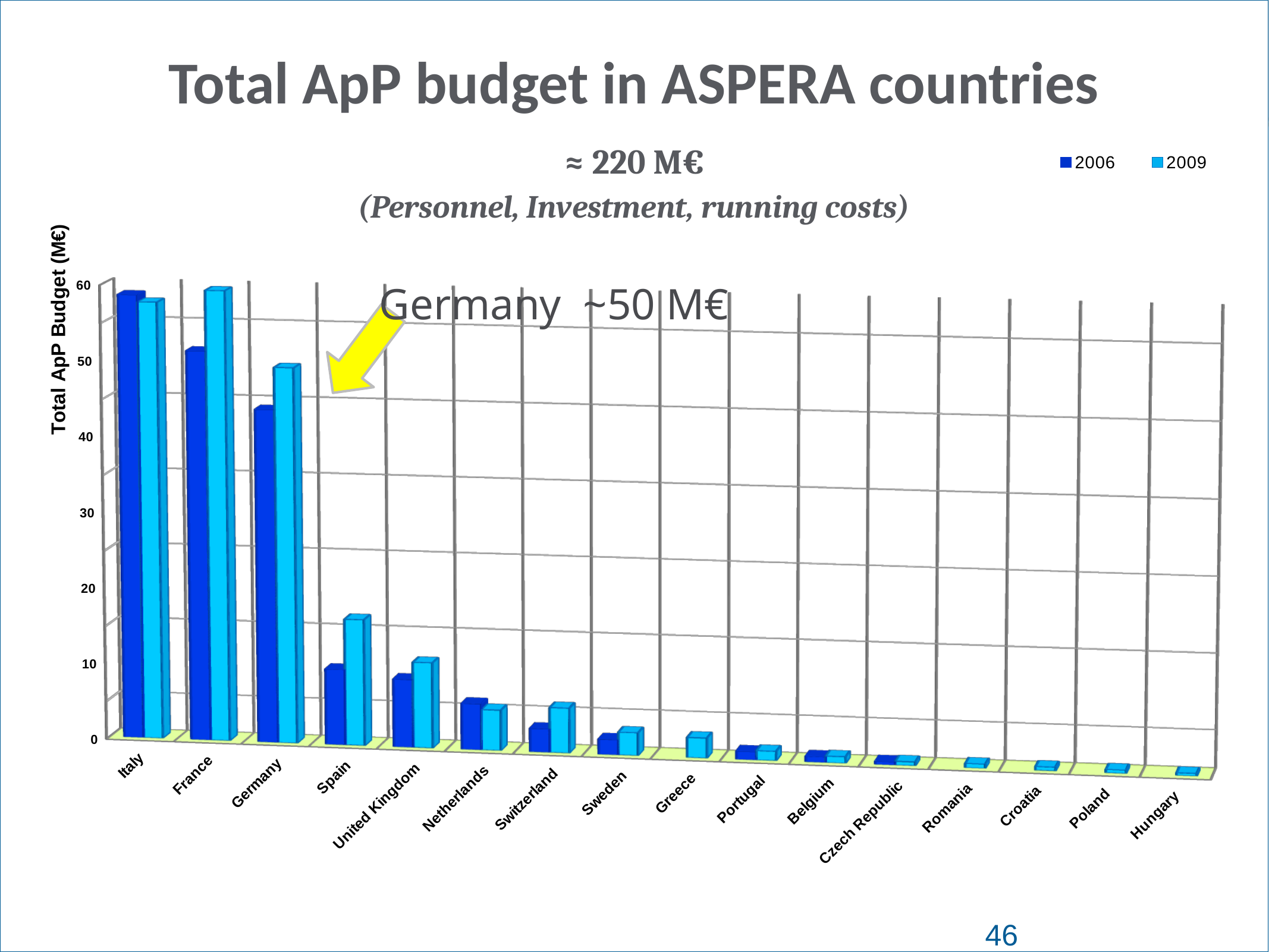
Is the 2006 value for Netherlands greater or less than 10? less Which country has the highest 2006 value? Italy Is the 2006 value for Italy greater or less than 50? greater Do the values generally rise or fall moving from Italy to Hungary along the x axis? fall How many series does the legend list? 2 Is the 2009 value for France greater or less than 50? greater How many countries are shown on the x axis? 16 What is the title of the vertical axis? Total ApP Budget (M€) For Germany, which series has the larger value, 2006 or 2009? 2009 What kind of chart is shown on the slide? bar chart